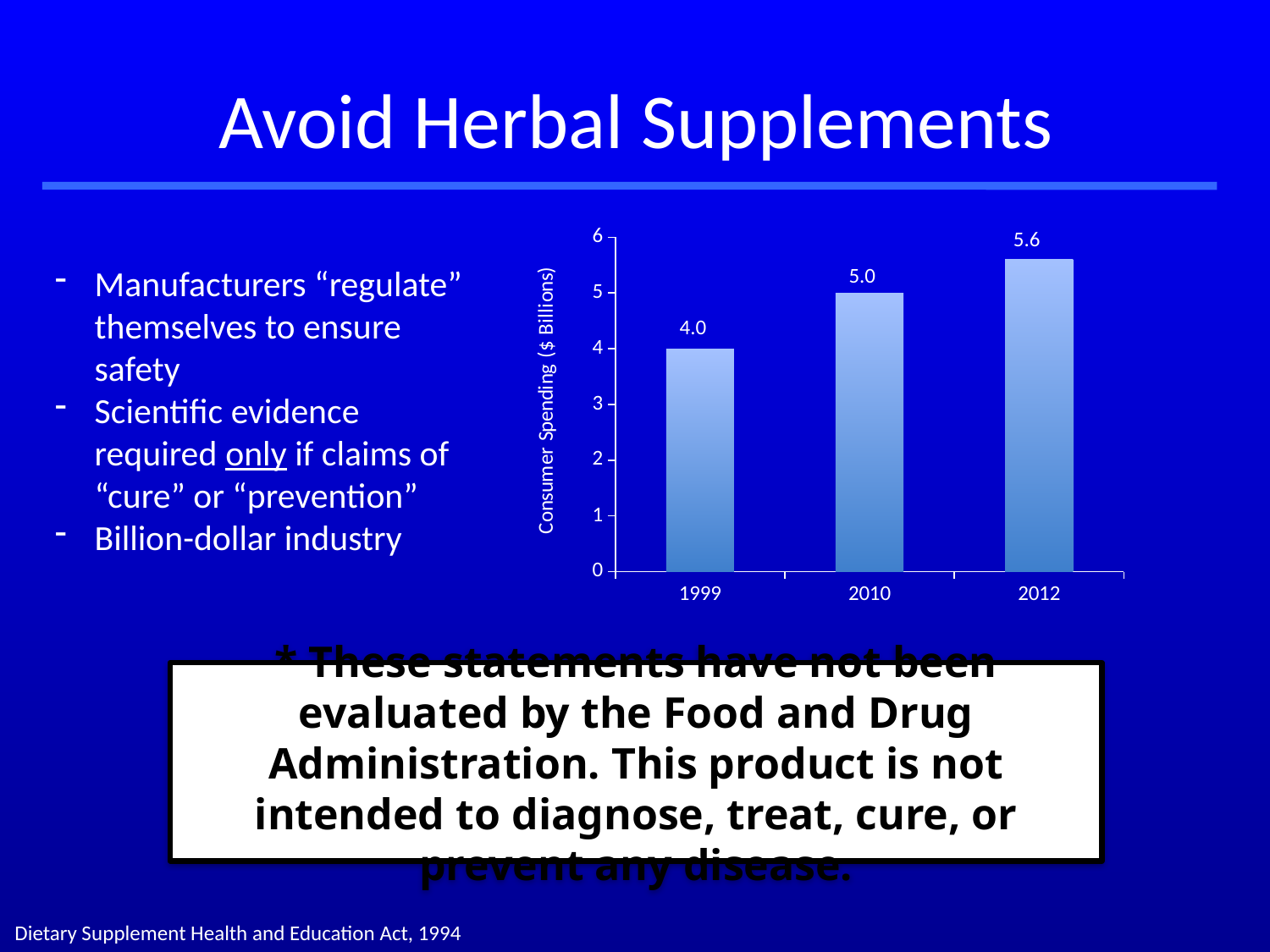
What kind of chart is shown on the slide? bar chart What is the label of the vertical axis of the chart? Consumer Spending ($ Billions) Do the consumer spending values rise or fall from 1999 to 2012? rise What is the difference in consumer spending between 2010 and 1999? 1.0 Which year has the lowest consumer spending? 1999 Which year has the highest consumer spending? 2012 What is the consumer spending value for 2010? 5.0 What is the difference in consumer spending between 2012 and 1999? 1.6 What is the consumer spending value for 2012? 5.6 What is the consumer spending value for 1999? 4.0 Which year has higher consumer spending, 2010 or 2012? 2012 How many years are shown on the chart? 3